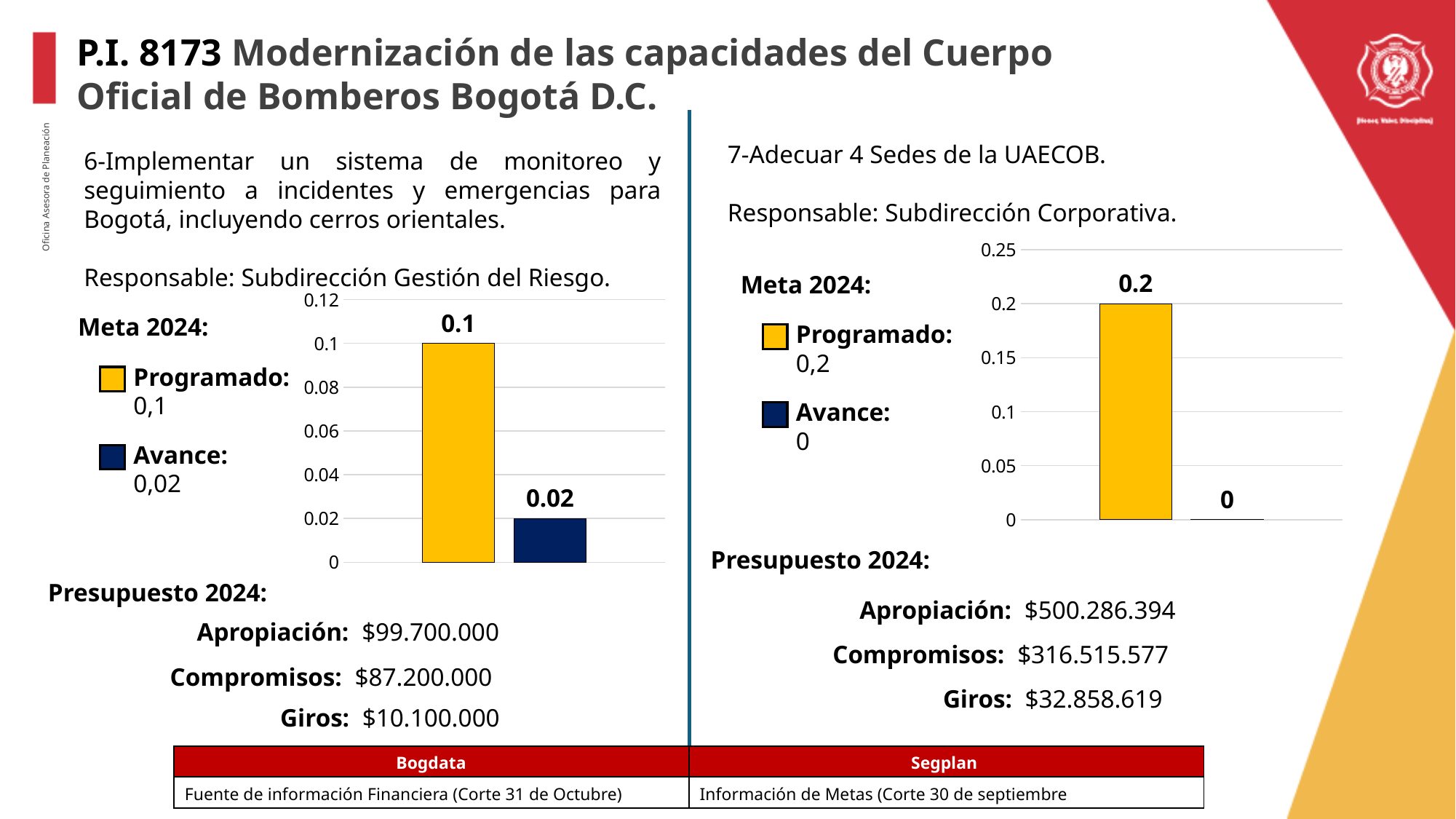
On the right chart (Meta 7), what is the difference between the Programado and Avance values? 0.2 On the right chart (Meta 7), which bar is the lowest? Avance On the right chart (Meta 7), what is the value of the Avance bar? 0 On the left chart (Meta 6), what is the difference between the Programado and Avance values? 0.08 How many bars are plotted on the right chart (Meta 7)? 2 On the left chart (Meta 6), what is the value of the Programado bar? 0.1 What type of chart is used on the left side of the slide (Meta 6)? Bar chart On the right chart (Meta 7), what is the value of the Programado bar? 0.2 On the left chart (Meta 6), which bar is higher, Programado or Avance? Programado On the left chart (Meta 6), what is the value of the Avance bar? 0.02 On the left chart (Meta 6), what is the maximum value shown on the vertical axis? 0.12 On the right chart (Meta 7), what colour is the Programado bar? Yellow